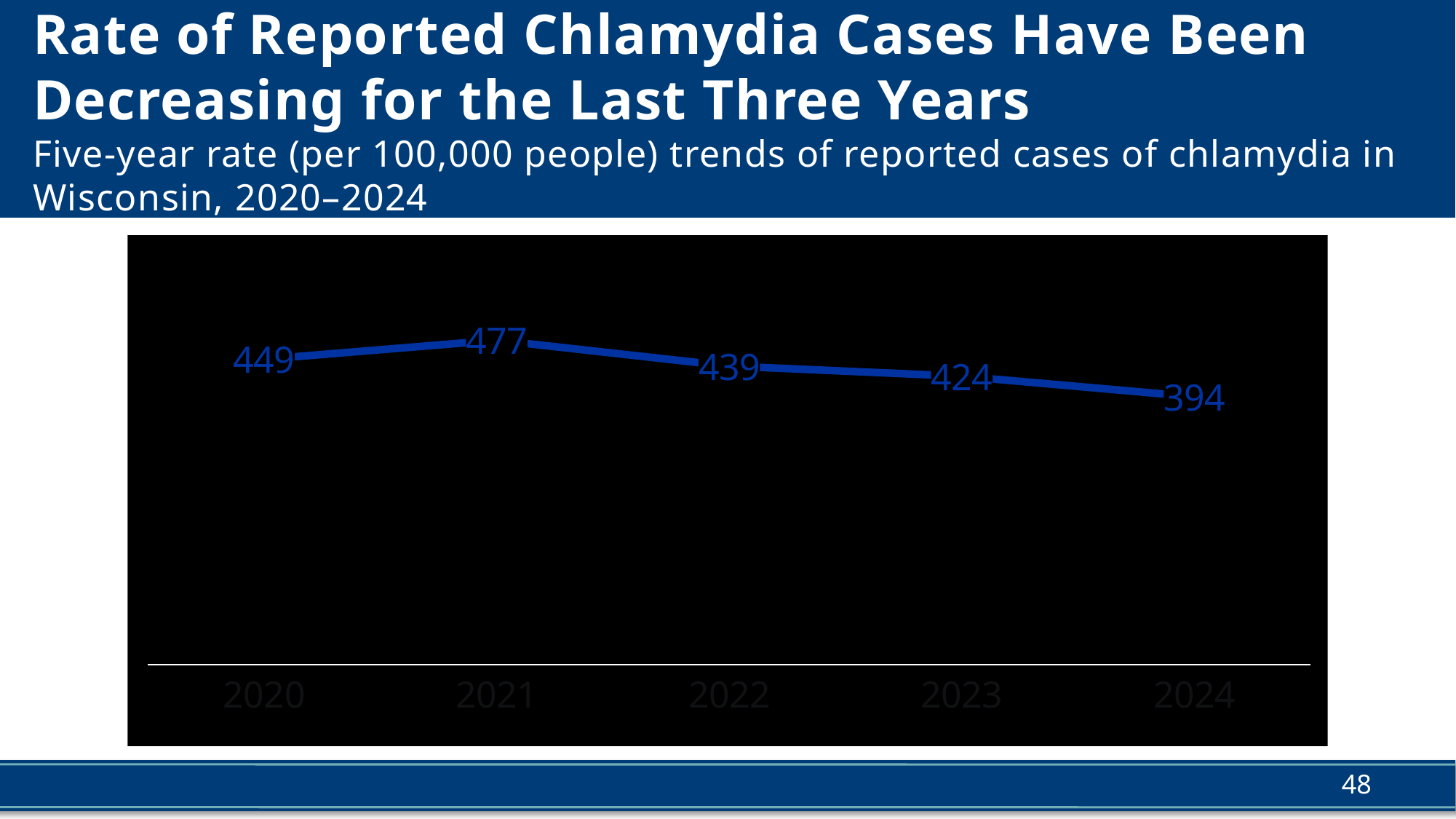
Which year has the lowest rate of reported chlamydia cases? 2024 What is the rate of reported chlamydia cases in 2024? 394 How many years are plotted on the chart? 5 What is the difference between the rate in 2021 and the rate in 2024? 83 What is the rate of reported chlamydia cases in 2020? 449 Do the rates rise or fall from 2021 to 2024? Fall What is the rate of reported chlamydia cases in 2023? 424 What is the difference between the rate in 2022 and the rate in 2023? 15 What kind of chart is shown on the slide? Line chart Which year has a higher rate, 2020 or 2022? 2020 What is the rate of reported chlamydia cases in 2021? 477 Which year has the highest rate of reported chlamydia cases? 2021